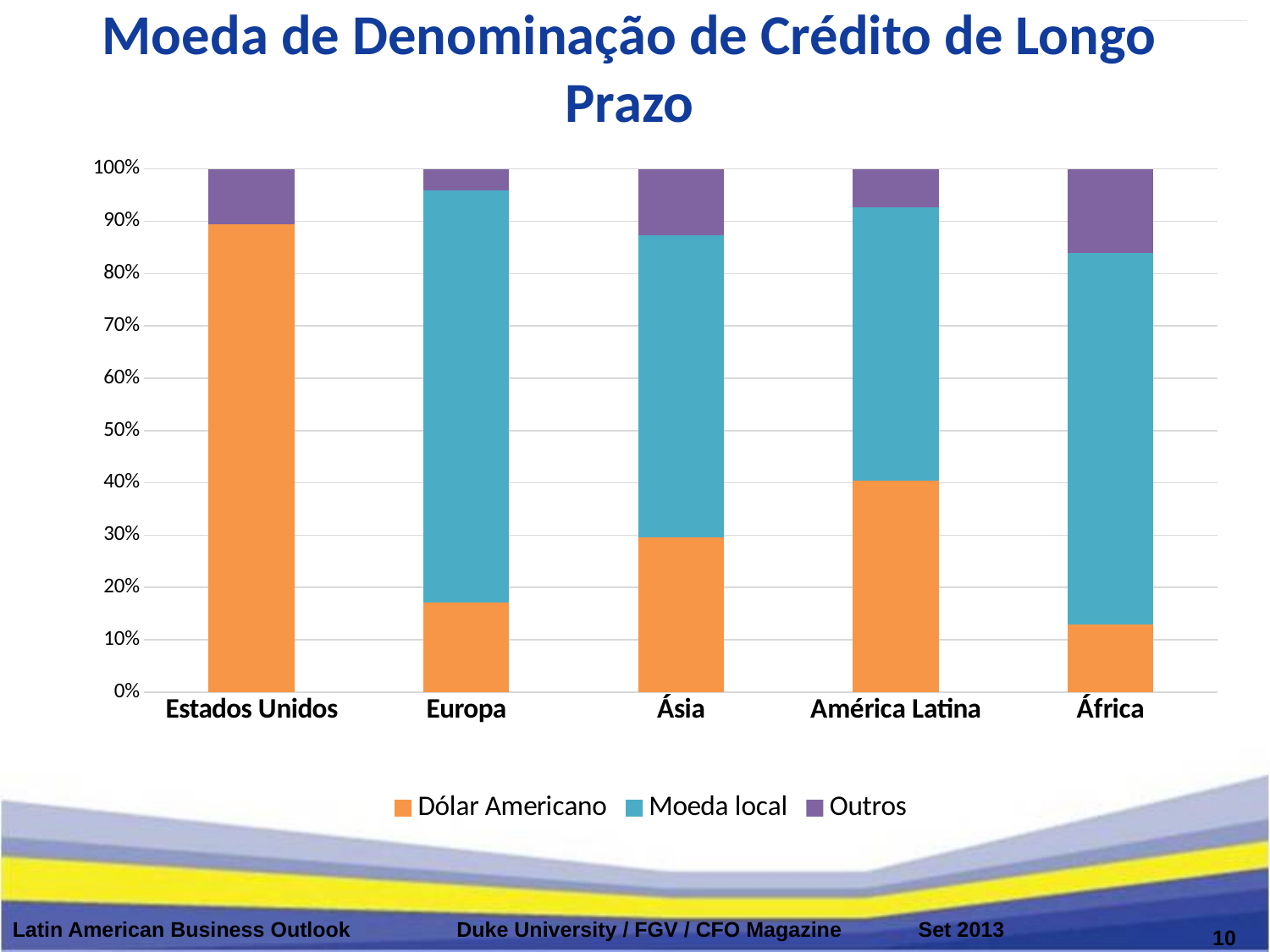
Is the Dólar Americano share for Europa greater or less than 20%? less Is the Dólar Americano share for Estados Unidos greater or less than 80%? greater Is the Dólar Americano share for América Latina greater or less than 50%? less How many regions are shown on the x axis of the chart? 5 Which has a larger Dólar Americano share, Ásia or Europa? Ásia Which region has the highest share of Moeda local? Europa Which region has the highest share of Outros? África What kind of chart is shown on the slide? Stacked bar chart Which region has the highest share of Dólar Americano? Estados Unidos Which region has the lowest share of Dólar Americano? África What is the title of the chart on the slide? Moeda de Denominação de Crédito de Longo Prazo How many series does the legend list? 3